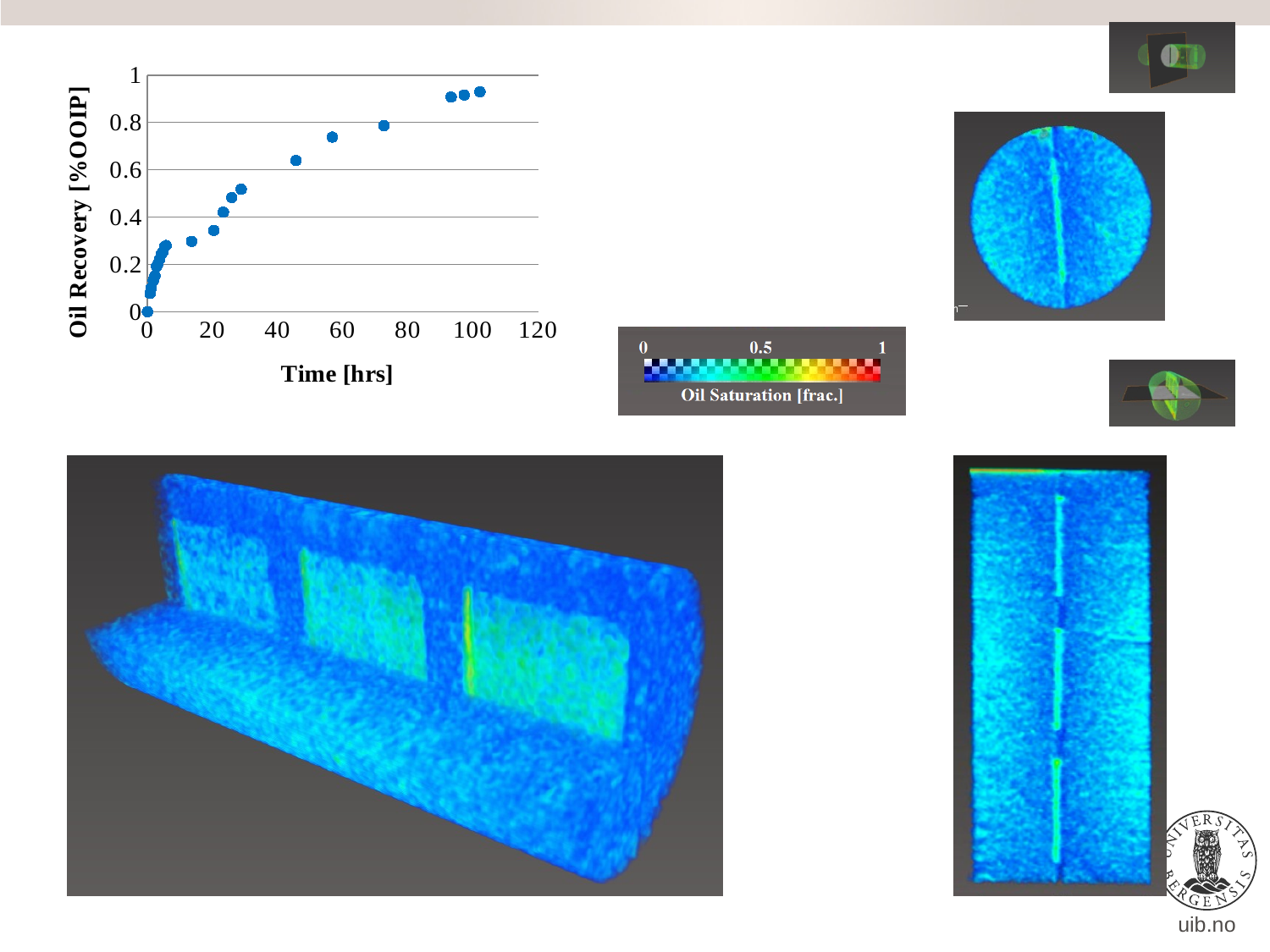
Which data point has the higher oil recovery, the one near 100 hours or the one near 20 hours? the one near 100 hours What is the title of the y axis of the chart? Oil Recovery [%OOIP] Is the oil recovery for the data point near 30 hours greater or less than 0.6? less What is the title of the x axis of the chart? Time [hrs] Is the oil recovery for the data point near 20 hours greater or less than 0.4? less Is the oil recovery for the data point near 10 hours greater or less than 0.4? less Does oil recovery rise or fall as time increases along the x axis? rise What kind of chart is shown on the slide? scatter chart